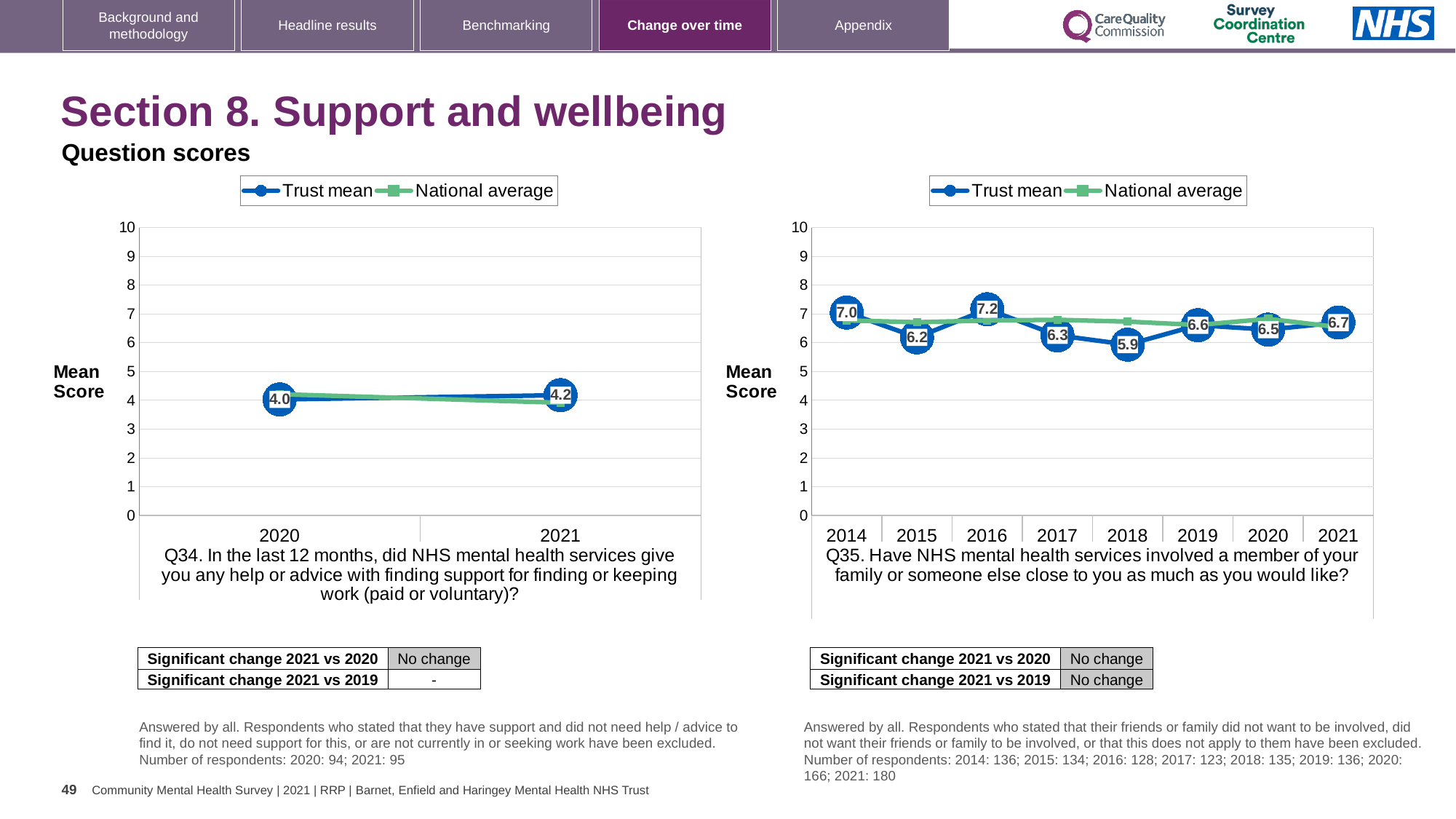
In the Q35 chart on the right, is the National average for 2021 greater or less than 6? greater In the Q35 chart on the right, what is the Trust mean for 2021? 6.7 In the Q35 chart on the right, which year has the highest Trust mean? 2016 In the Q35 chart on the right, which year has the lowest Trust mean? 2018 In the Q34 chart on the left, by how much did the Trust mean change from 2020 to 2021? 0.2 In the Q34 chart on the left, how many years are shown on the x axis? 2 In the Q35 chart on the right, is the Trust mean higher in 2014 or in 2015? 2014 In the Q35 chart on the right, what is the difference between the Trust mean in 2016 and in 2018? 1.3 In the Q34 chart on the left, what is the Trust mean for 2021? 4.2 How many series does the legend of the Q35 chart on the right list? 2 In the Q34 chart on the left, what is the Trust mean for 2020? 4.0 In the Q35 chart on the right, what is the Trust mean for 2018? 5.9